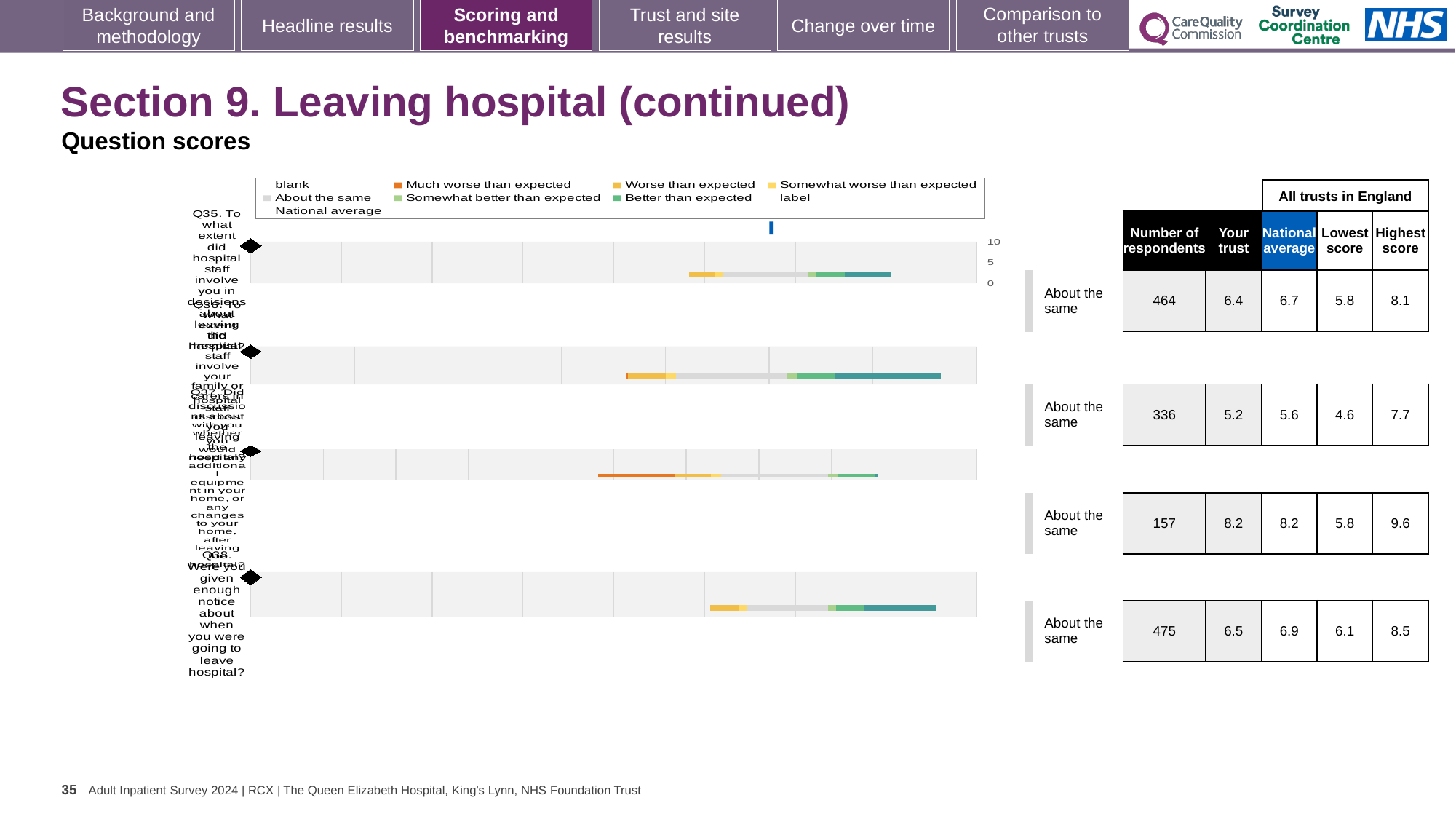
For Q36 (the second row), which is larger: the 'Your trust' score or the national average? National average How many questions (categories) are plotted in the question scores chart? 4 Which question has the highest 'Your trust' score in the table? Q37 How many entries does the chart legend list? 9 What benchmark category is shown for all four questions on this slide? About the same Which question has the fewest respondents in the table? Q37 What is the lowest score across all trusts in England for Q36 (the second row of the table)? 4.6 What is the difference between the national average and the 'Your trust' score for Q35 (the first row)? 0.3 What is the 'Your trust' score for Q38 (the last row of the table)? 6.5 What kind of chart is used to show the question scores on this slide? bar chart What is the highest score across all trusts in England for Q37 (the third row of the table)? 9.6 In the table next to the chart, what is the number of respondents for Q35 (the first row)? 464